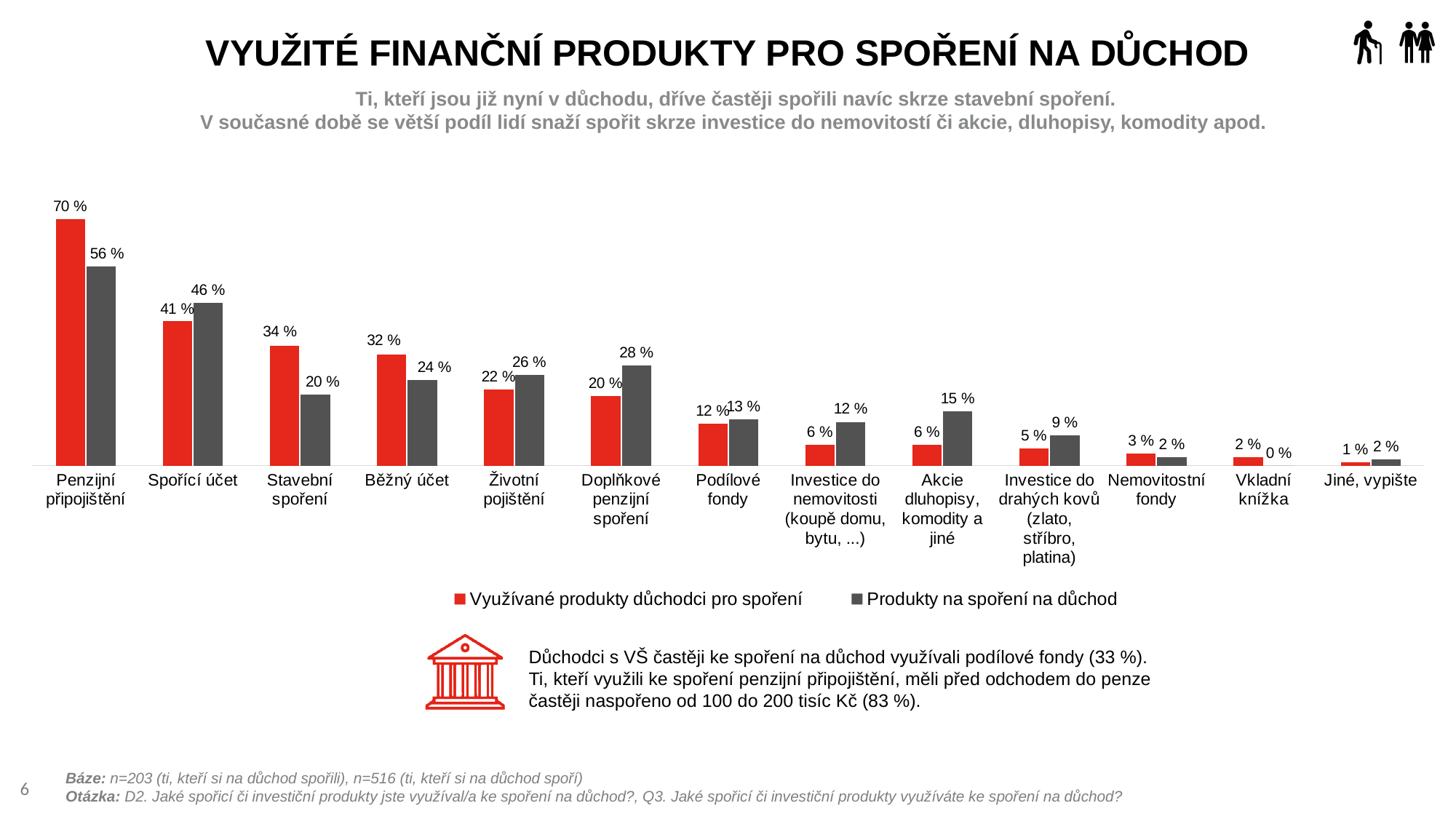
For Spořící účet, which series has the larger value? Produkty na spoření na důchod What is the value for Penzijní připojištění in the series Využívané produkty důchodci pro spoření? 70 % What kind of chart is shown on the slide? Bar chart Which category has the lowest value in the series Produkty na spoření na důchod? Vkladní knížka Which category has the highest value in the series Produkty na spoření na důchod? Penzijní připojištění What is the difference between the two series for Penzijní připojištění? 14 % How many series does the legend list? 2 What is the value for Akcie, dluhopisy, komodity a jiné in the series Produkty na spoření na důchod? 15 % What is the difference between the two series for Stavební spoření? 14 % How many categories are shown on the x axis? 13 What is the value for Stavební spoření in the series Produkty na spoření na důchod? 20 % For Běžný účet, which series has the larger value? Využívané produkty důchodci pro spoření